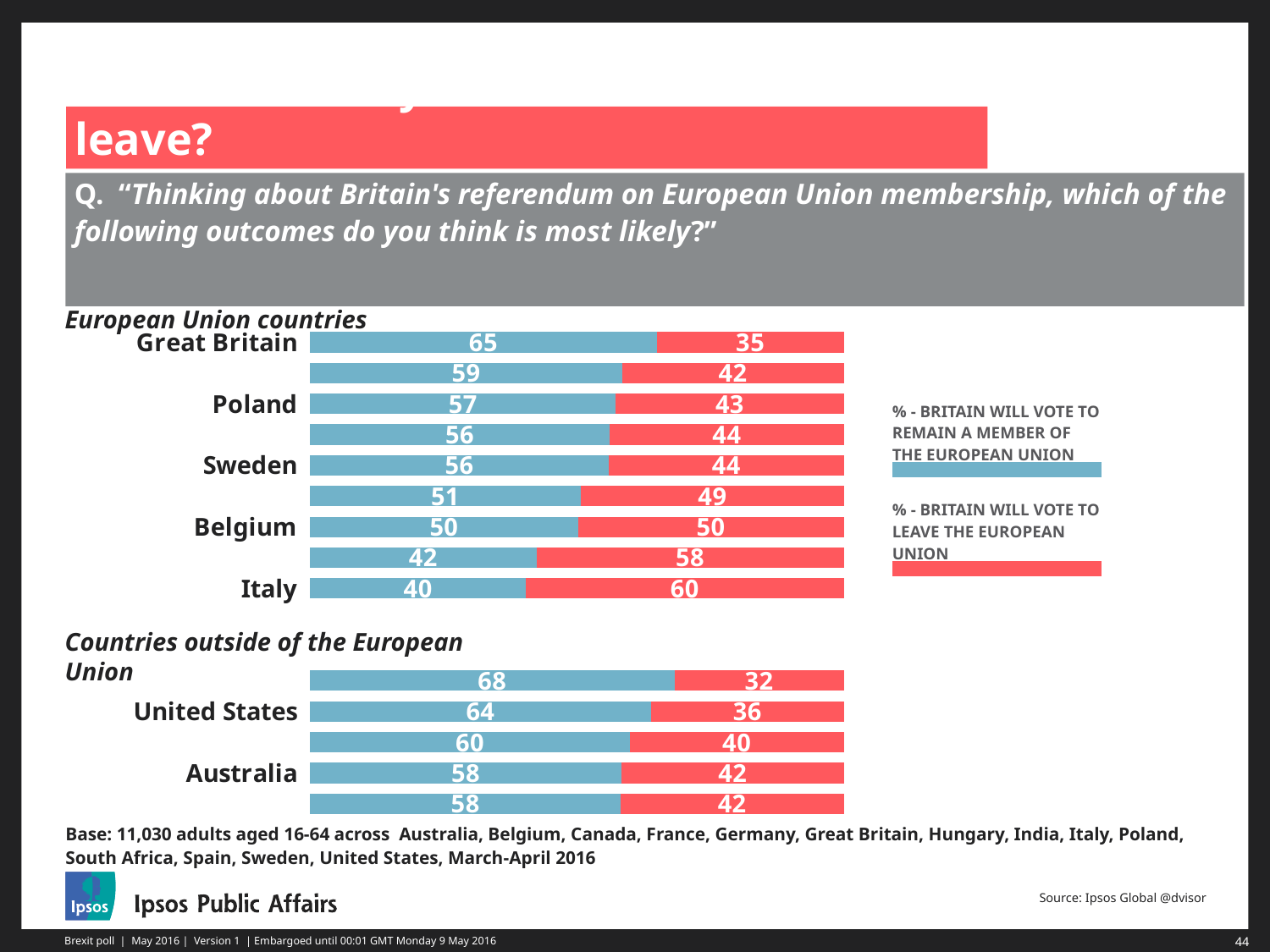
In the Countries outside of the European Union chart, what percentage of United States respondents think Britain will vote to remain a member of the European Union? 64 What type of chart is used on this slide? Stacked bar chart In the European Union countries chart, what percentage of Great Britain respondents think Britain will vote to remain a member of the European Union? 65 In the European Union countries chart, which is larger for Sweden: the percentage saying remain or the percentage saying leave? remain In the European Union countries chart, what is the total of the two segments for Belgium? 100 In the European Union countries chart, how many bars are plotted? 9 In the European Union countries chart, what percentage of Italy respondents think Britain will vote to leave the European Union? 60 In the European Union countries chart, which labelled country has the lowest percentage saying Britain will vote to remain? Italy In the Countries outside of the European Union chart, how many bars are plotted? 5 In the Countries outside of the European Union chart, what percentage of Australia respondents think Britain will vote to leave the European Union? 42 In the European Union countries chart, what is the difference between the remain percentages for Great Britain and Poland? 8 In the European Union countries chart, which labelled country has the highest percentage saying Britain will vote to remain? Great Britain